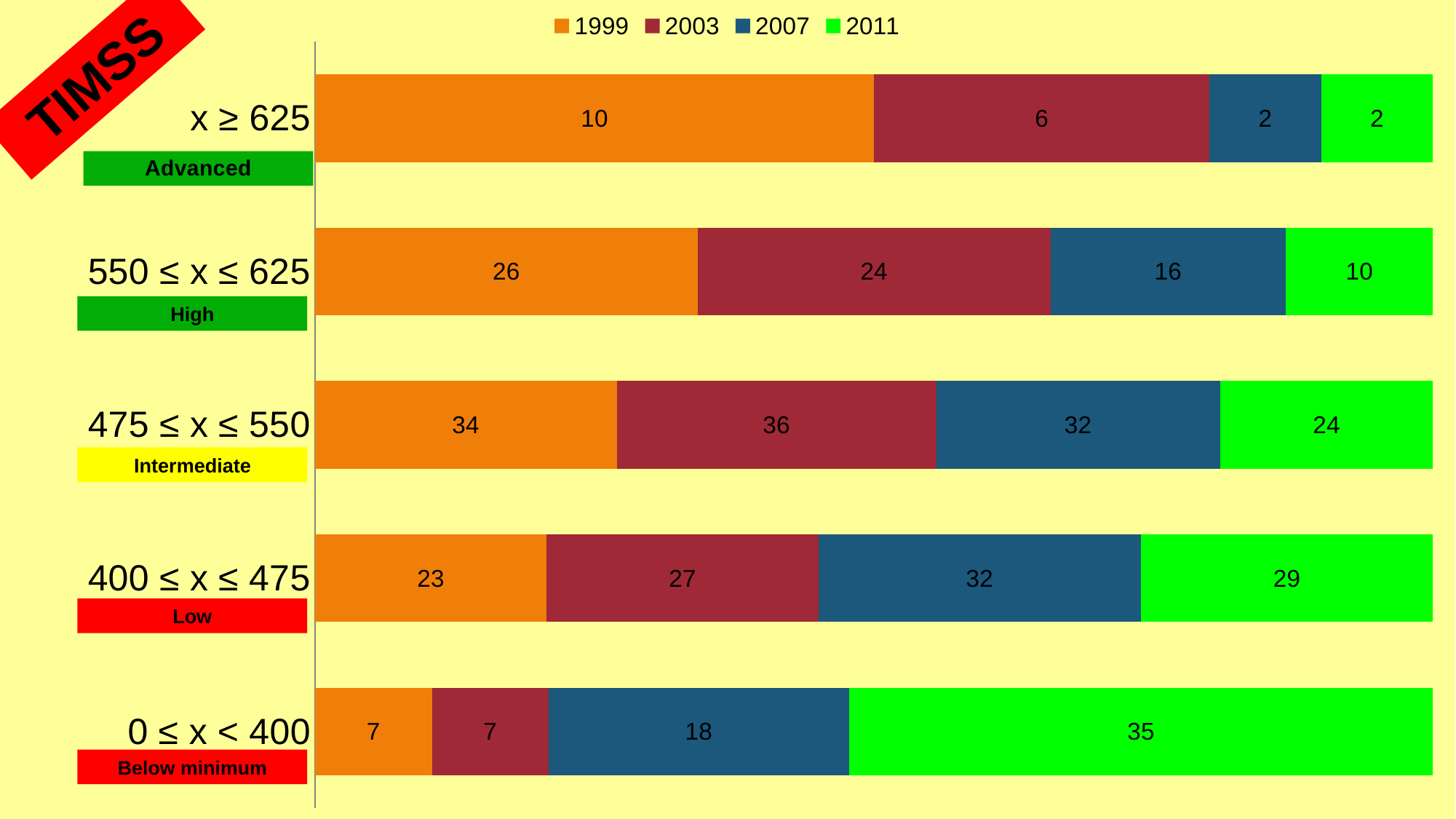
What is the difference between the 2011 and 2007 values in the 0 ≤ x < 400 (Below minimum) category? 17 Which category has the lowest value for the 1999 series? 0 ≤ x < 400 (Below minimum) What is the value for 2007 in the 550 ≤ x ≤ 625 (High) category? 16 How many series does the legend list? 4 What is the value for 2011 in the 0 ≤ x < 400 (Below minimum) category? 35 What is the value for 2003 in the x ≥ 625 (Advanced) category? 6 Which category has the highest value for the 2011 series? 0 ≤ x < 400 (Below minimum) What is the value for 1999 in the 475 ≤ x ≤ 550 (Intermediate) category? 34 In the 400 ≤ x ≤ 475 (Low) category, which is larger: the 2007 value or the 2011 value? 2007 What is the difference between the 1999 and 2011 values in the 550 ≤ x ≤ 625 (High) category? 16 How many categories (performance levels) are shown in the chart? 5 What kind of chart is shown on the slide? Stacked bar chart